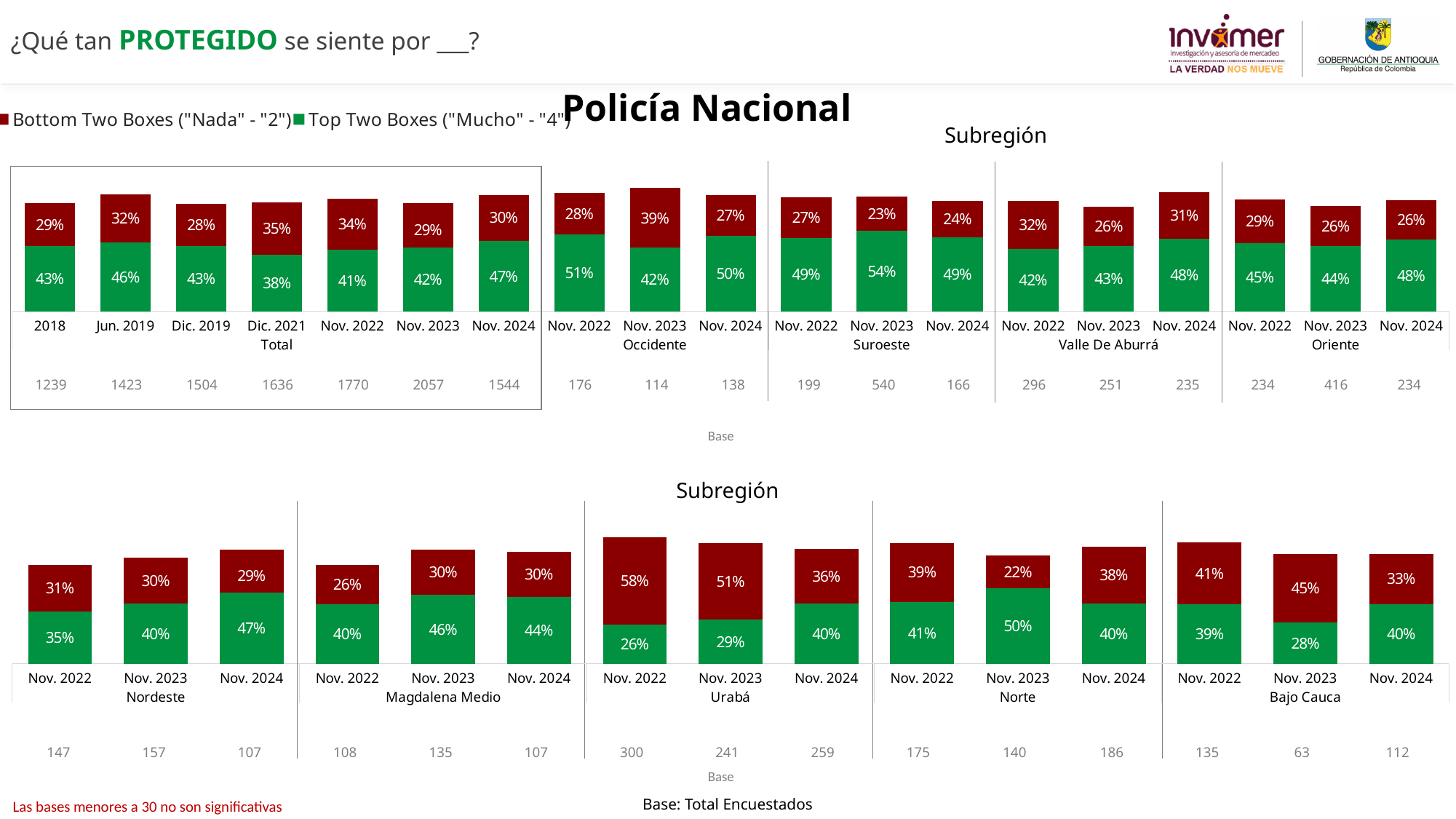
In the top chart, which bar has the highest Top Two Boxes value? Suroeste Nov. 2023 (54%) In the top chart, what is the Top Two Boxes ("Mucho" - "4") value for Total in Nov. 2024? 47% In the bottom chart, which has the larger Top Two Boxes value in Nov. 2023: Norte or Bajo Cauca? Norte How many series does the legend list? 2 In the bottom chart, which bar has the lowest Top Two Boxes value? Urabá Nov. 2022 (26%) In the top chart, what is the difference between the Top Two Boxes and Bottom Two Boxes values for Total in Nov. 2024? 17 percentage points What kind of chart is used on this slide? Stacked bar chart In the bottom chart, does the Top Two Boxes value for Nordeste rise or fall from Nov. 2022 to Nov. 2024? Rises In the top chart, how many bars are shown in the Total section? 7 In the top chart, what is the base (number of respondents) for Total in Nov. 2023? 2057 In the bottom chart, what is the Bottom Two Boxes ("Nada" - "2") value for Urabá in Nov. 2022? 58% In the bottom chart, what is the combined total of the two stacked segments for Urabá in Nov. 2022? 84%